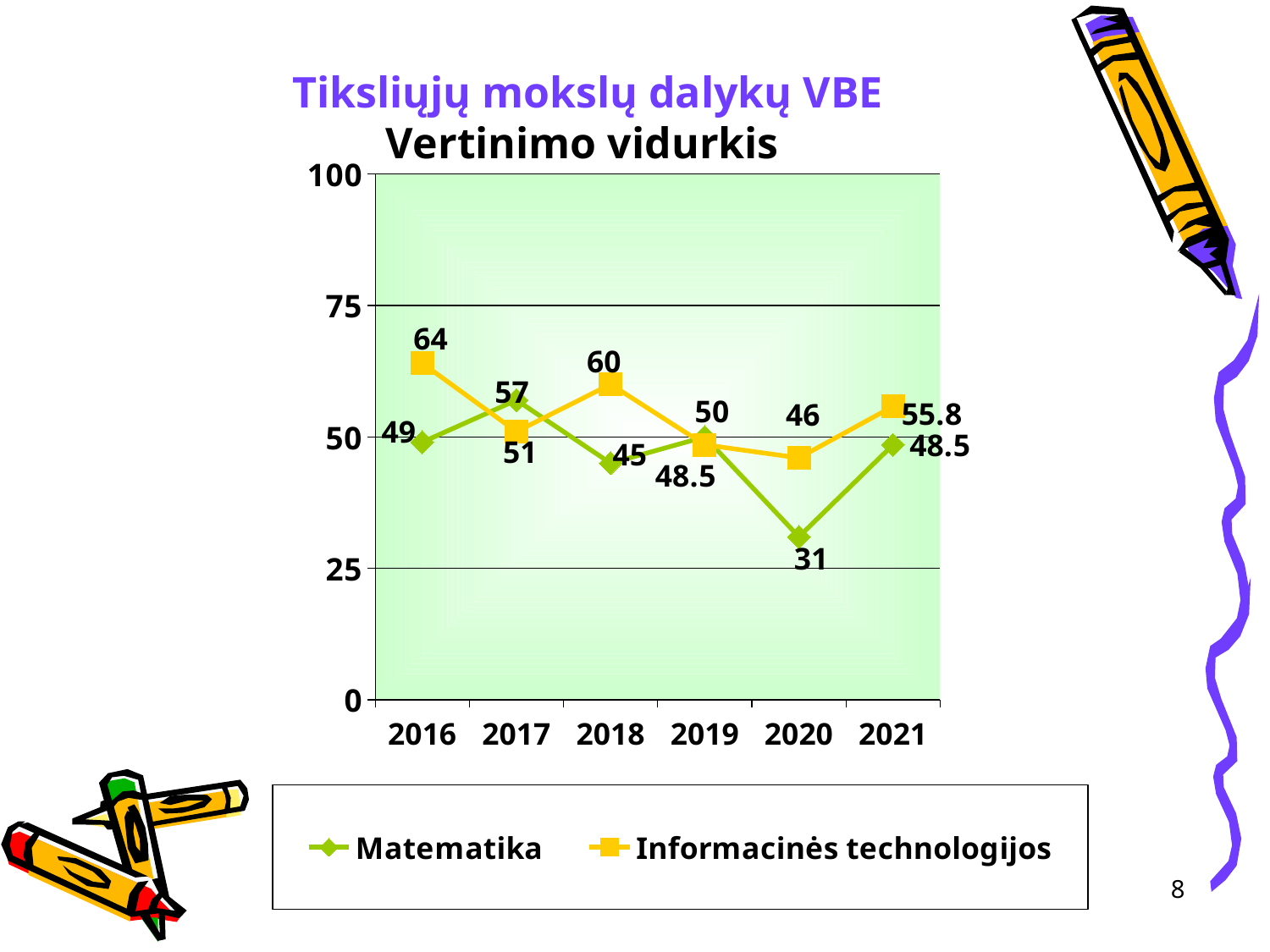
What is the difference between the Informacinės technologijos and Matematika values in 2020? 15 What kind of chart is shown on the slide? Line chart What is the value for Informacinės technologijos in 2016? 64 In which year is the Matematika value lowest? 2020 What is the value for Matematika in 2017? 57 What is the value for Informacinės technologijos in 2021? 55.8 In which year is the Informacinės technologijos value highest? 2016 What is the title of the chart? Vertinimo vidurkis What is the value for Matematika in 2020? 31 Which series has the larger value in 2018, Matematika or Informacinės technologijos? Informacinės technologijos How many series does the legend list? 2 How many years are shown on the x axis? 6